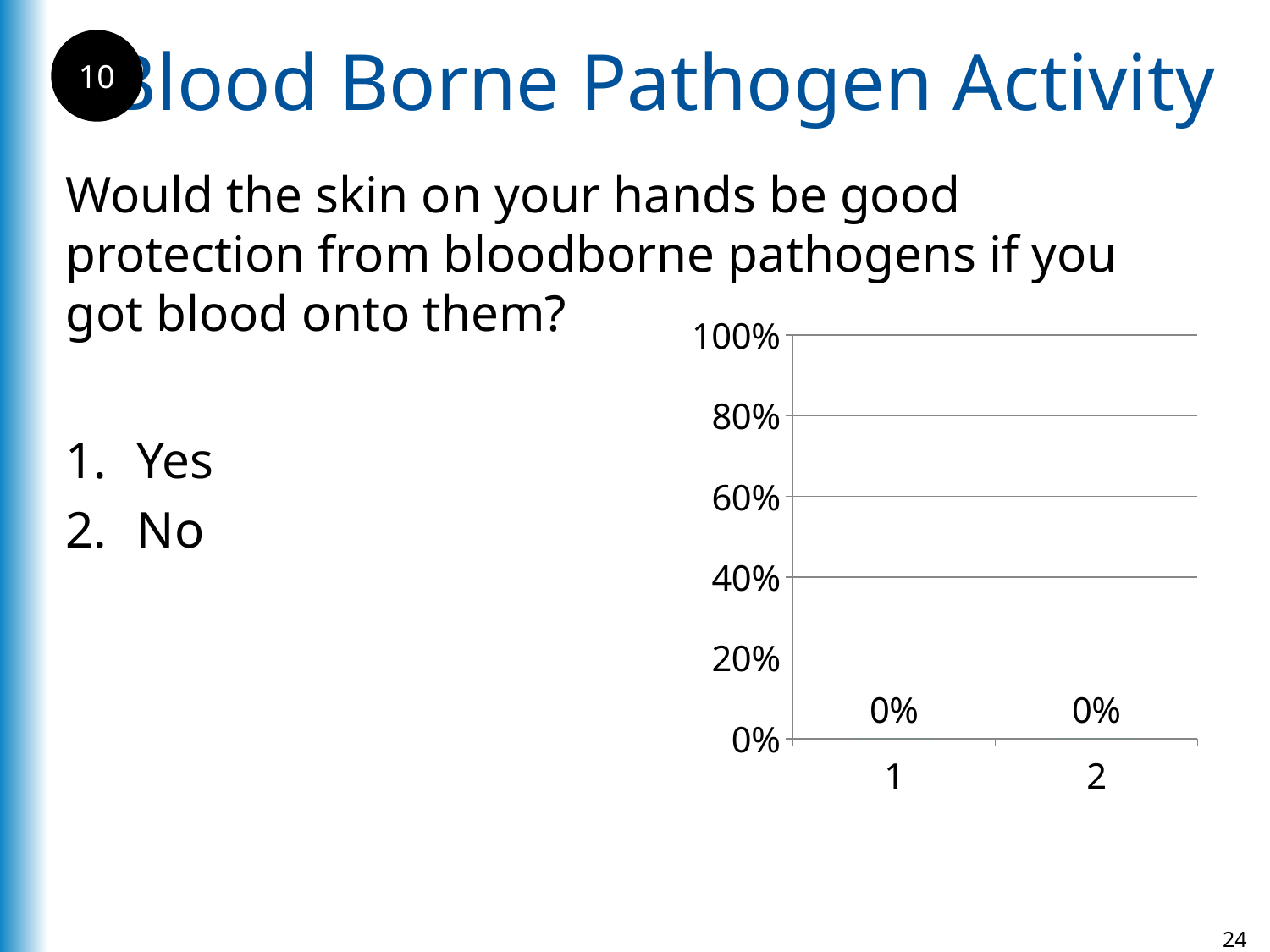
What is the value shown for category 1 in the chart? 0% What is the value shown for category 2 in the chart? 0% Is the value for category 2 greater or less than 40%? less What is the lowest tick label on the y axis of the chart? 0% What kind of chart is shown on the slide? bar chart Is the value for category 1 greater or less than 20%? less What is the difference between the values for category 1 and category 2? 0% What are the category labels on the x axis of the chart? 1 and 2 How many categories are shown on the x axis of the chart? 2 What is the highest tick label on the y axis of the chart? 100%